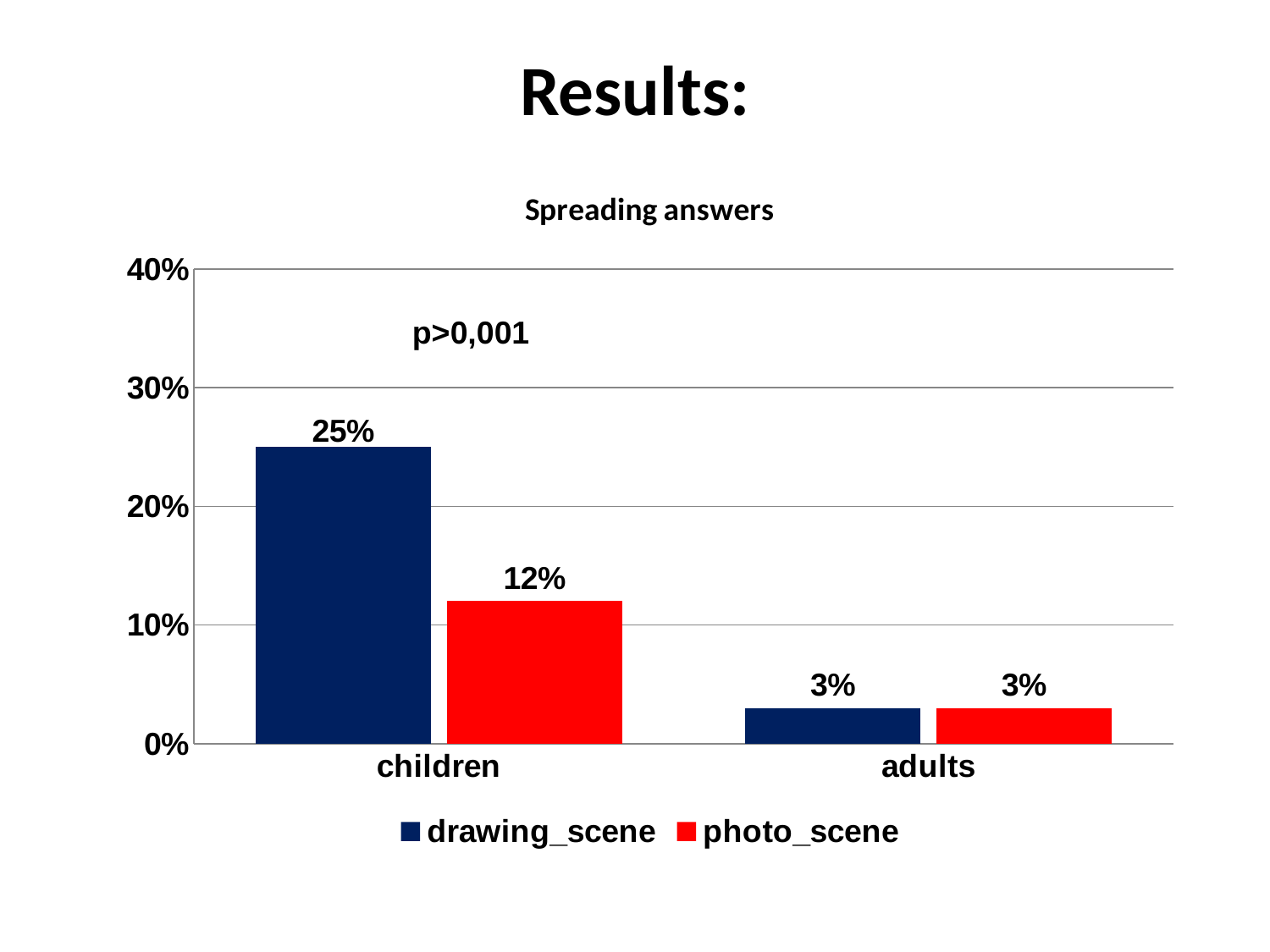
Which category has the highest drawing_scene value? children For children, which is larger: drawing_scene or photo_scene? drawing_scene What is the value for drawing_scene for adults? 3% Is the drawing_scene value for children greater or less than 20%? greater What is the title of the chart? Spreading answers How many categories are shown on the x axis? 2 How many series does the legend list? 2 What is the value for photo_scene for children? 12% What is the value for photo_scene for adults? 3% What is the value for drawing_scene for children? 25% What kind of chart is shown? bar chart What is the difference between the drawing_scene and photo_scene values for children? 13%